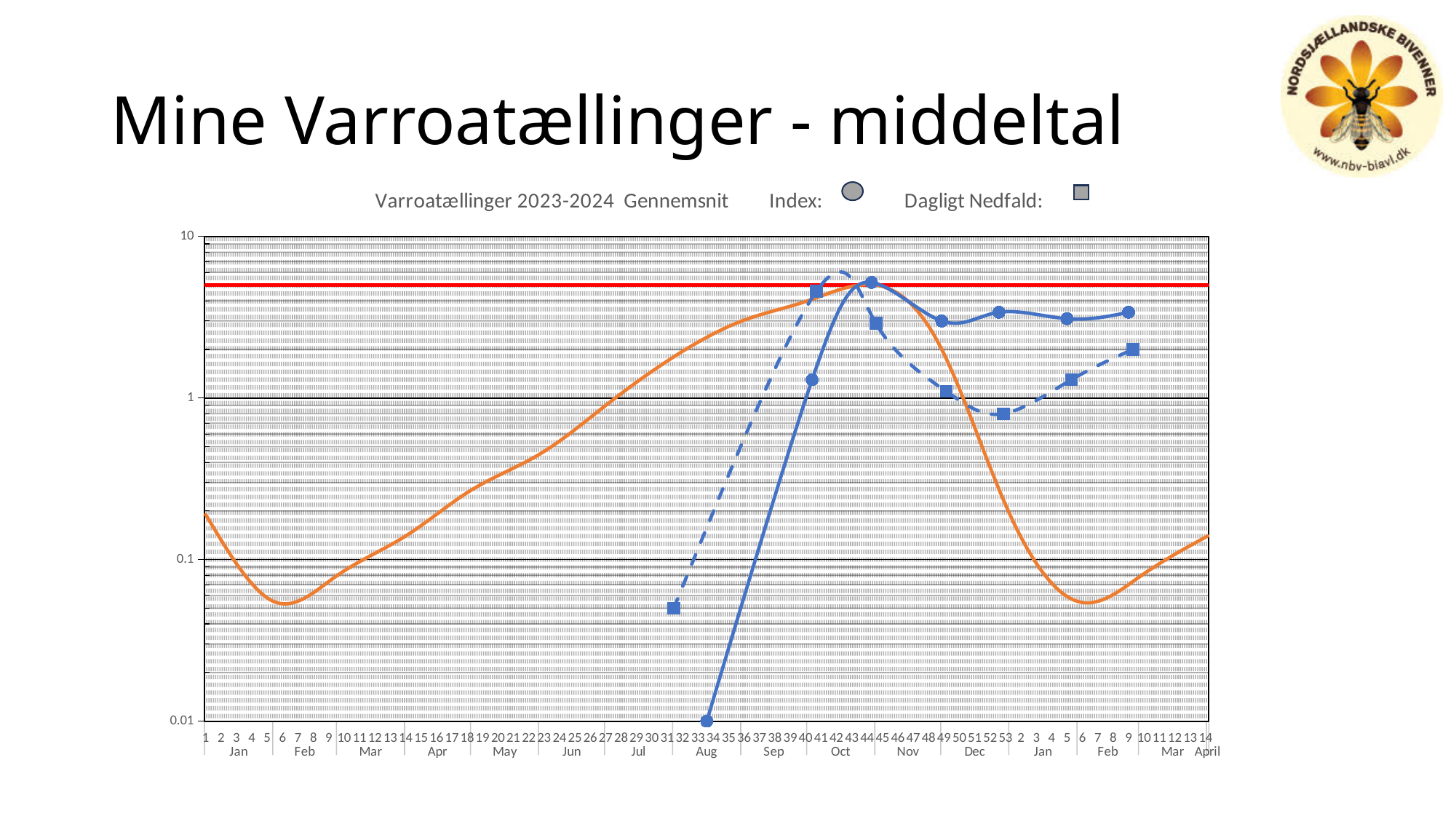
Which marker shape does the legend use for the Dagligt Nedfald series? square At which week does the Index series reach its highest value? 44 What is the title of the chart? Varroatællinger 2023-2024 Gennemsnit At which week does the Index series have its lowest value? 33 Is the Index value at week 44 greater or less than 1? greater Is the Dagligt Nedfald value at week 31 greater or less than 0.1? less Which is larger, the Index value at week 44 or at week 49? week 44 How many marked data points does the Index series have? 7 What is the Index value at week 33? 0.01 How many series does the chart legend list? 2 What kind of chart is shown on the slide? line chart Does the Index series rise or fall between week 33 and week 44? rise